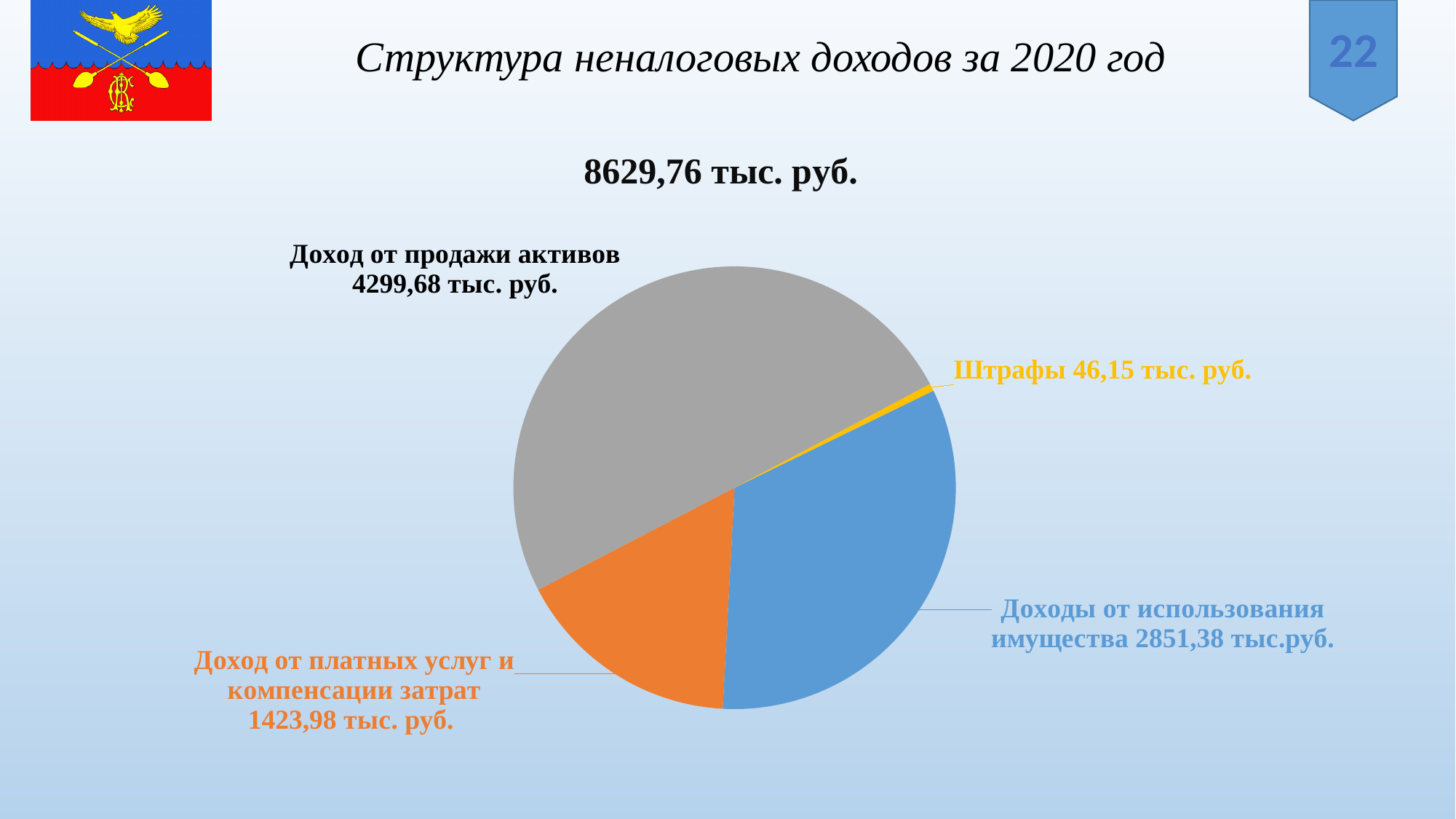
What total amount is printed above the pie chart? 8629,76 тыс. руб. What is the value for Доход от платных услуг и компенсации затрат? 1423,98 тыс. руб. What is the value for Доходы от использования имущества? 2851,38 тыс.руб. How many slices does the pie chart have? 4 Which is larger: Доходы от использования имущества or Доход от платных услуг и компенсации затрат? Доходы от использования имущества What is the value for Доход от продажи активов? 4299,68 тыс. руб. What colour is the slice for Доход от платных услуг и компенсации затрат? orange Which category has the smallest slice of the pie? Штрафы What is the value for Штрафы? 46,15 тыс. руб. Which category has the largest slice of the pie? Доход от продажи активов What is the difference between Доход от продажи активов and Доходы от использования имущества? 1448,30 тыс. руб. What kind of chart is shown on the slide? pie chart